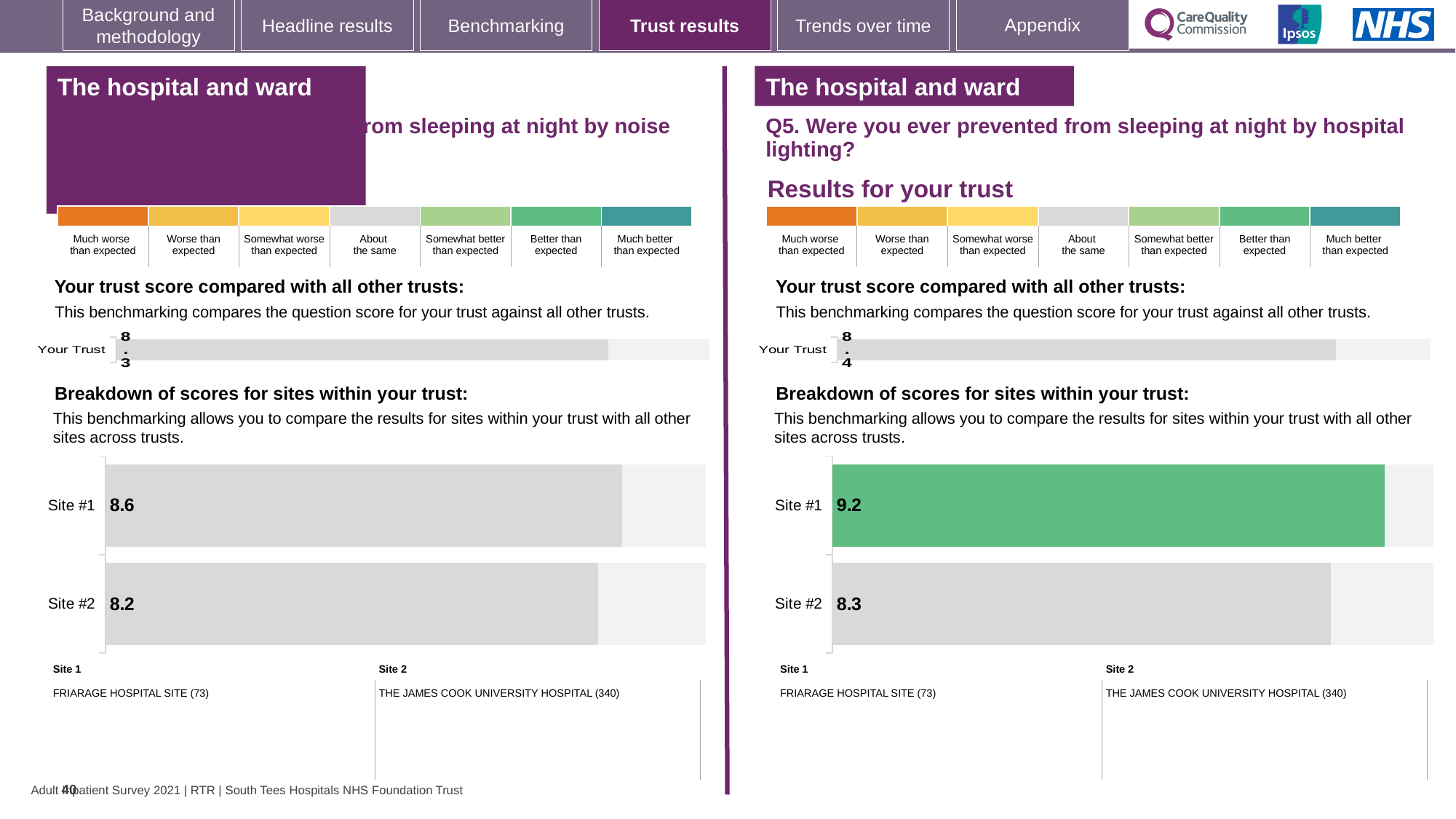
On the right-hand site breakdown chart (Q5, hospital lighting), what is the difference between the Site #1 and Site #2 scores? 0.9 What type of chart is the site breakdown chart on the right-hand side (Q5, hospital lighting)? Bar chart On the right-hand 'Your trust score compared with all other trusts' chart (Q5), what is the score for Your Trust? 8.4 On the right-hand chart (Q5, hospital lighting), what is the score for Site #1? 9.2 On the left-hand chart (sleeping at night by noise), what is the score for Site #2? 8.2 On the left-hand chart (sleeping at night by noise), what is the score for Site #1? 8.6 On the left-hand site breakdown chart (noise), what is the difference between the Site #1 and Site #2 scores? 0.4 On the right-hand site breakdown chart (Q5, hospital lighting), which site has the highest score? Site #1 How many sites are shown in the right-hand site breakdown chart (Q5, hospital lighting)? 2 On the left-hand 'Your trust score compared with all other trusts' chart (noise), what is the score for Your Trust? 8.3 On the left-hand site breakdown chart (noise), which site has the lowest score? Site #2 On the right-hand chart (Q5, hospital lighting), what is the score for Site #2? 8.3